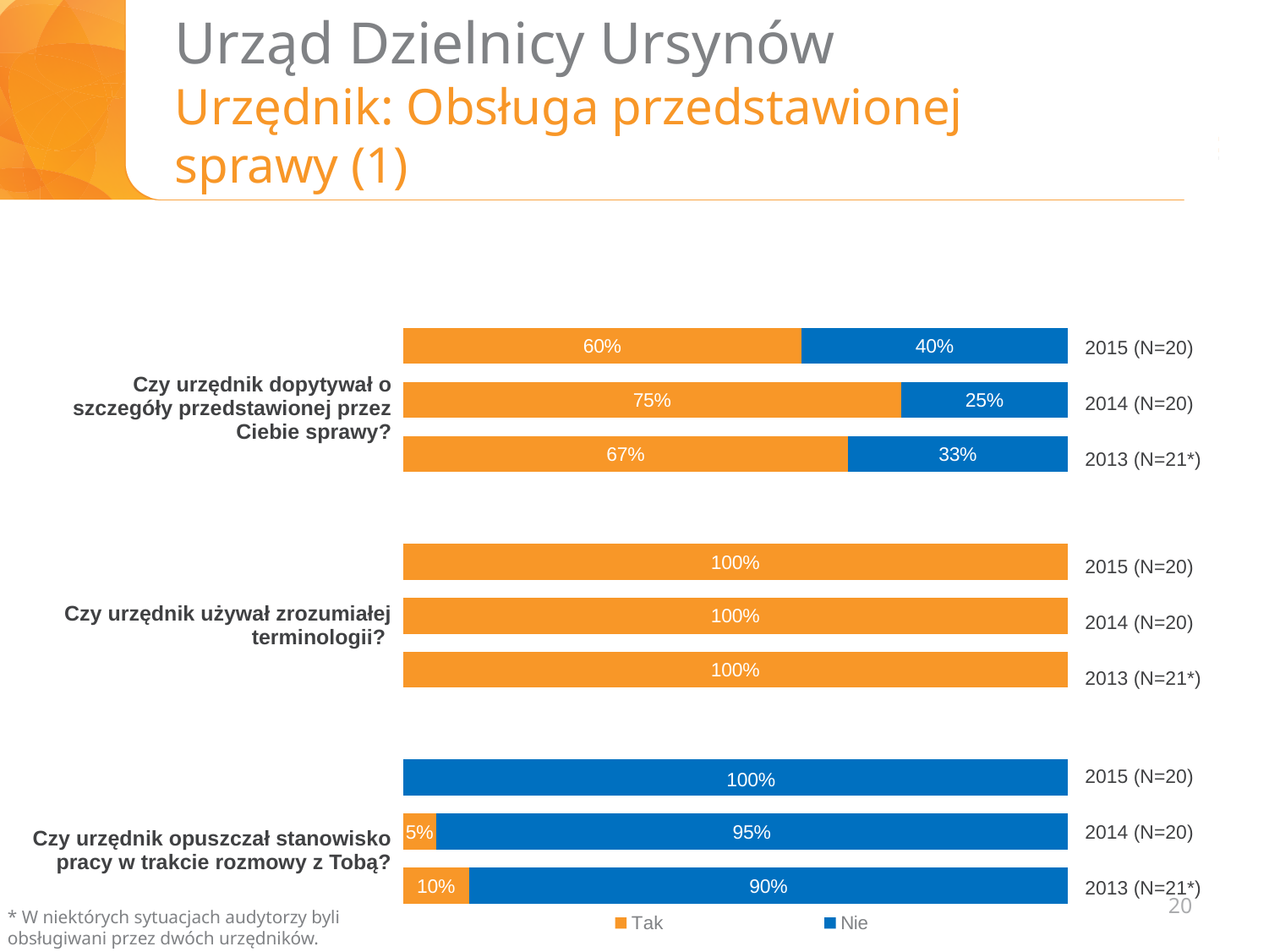
For "Czy urzędnik opuszczał stanowisko pracy w trakcie rozmowy z Tobą?", is the "Nie" share larger in 2014 or in 2013? 2014 What is the "Tak" value for 2013 (N=21*) for the question "Czy urzędnik dopytywał o szczegóły przedstawionej przez Ciebie sprawy?"? 67% For "Czy urzędnik dopytywał o szczegóły przedstawionej przez Ciebie sprawy?", which year has the lowest "Tak" share? 2015 (N=20) For "Czy urzędnik dopytywał o szczegóły przedstawionej przez Ciebie sprawy?", which year has the highest "Tak" share? 2014 (N=20) What share answered "Tak" to "Czy urzędnik używał zrozumiałej terminologii?" in 2014 (N=20)? 100% What type of chart is shown on the slide? Stacked bar chart What share answered "Nie" in 2015 (N=20) to "Czy urzędnik opuszczał stanowisko pracy w trakcie rozmowy z Tobą?"? 100% What share of respondents answered "Tak" in 2015 (N=20) to the question "Czy urzędnik dopytywał o szczegóły przedstawionej przez Ciebie sprawy?"? 60% What is the difference between the "Tak" shares for 2014 and 2015 for "Czy urzędnik dopytywał o szczegóły przedstawionej przez Ciebie sprawy?"? 15 percentage points What share answered "Nie" in 2014 (N=20) to "Czy urzędnik dopytywał o szczegóły przedstawionej przez Ciebie sprawy?"? 25% What is the "Tak" value for 2013 (N=21*) for "Czy urzędnik opuszczał stanowisko pracy w trakcie rozmowy z Tobą?"? 10% How many series does the legend list? 2